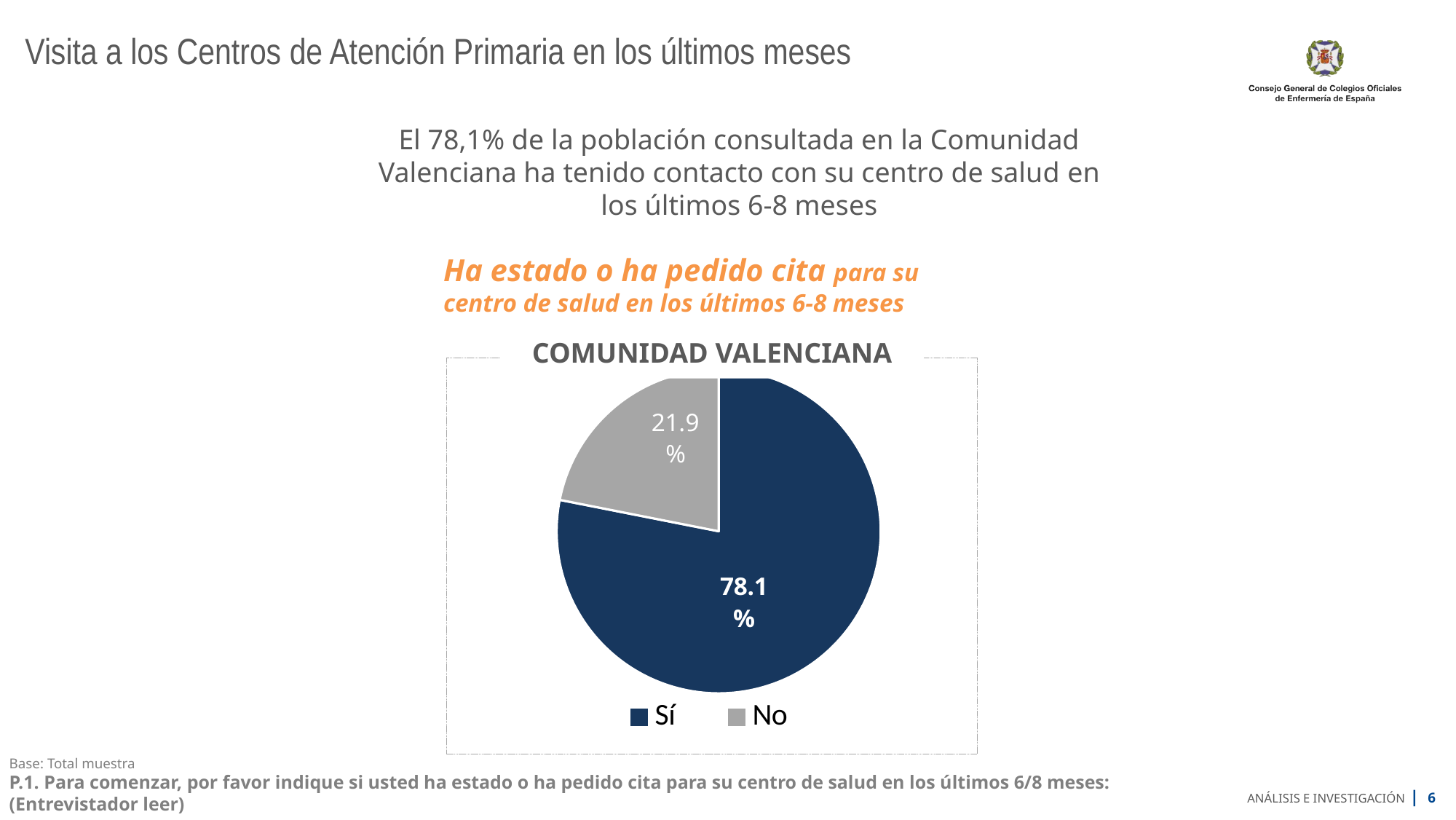
Which category has the largest slice in the pie chart? Sí What is the title of the pie chart? COMUNIDAD VALENCIANA Which category has the smallest slice in the pie chart? No What colour is the Sí slice in the pie chart? Dark blue What share of the pie does the Sí slice represent? 78.1% What is the difference between the Sí and No values in the pie chart? 56.2% What is the value for Sí in the pie chart? 78.1% How many entries does the legend of the pie chart list? 2 What kind of chart is shown under the title COMUNIDAD VALENCIANA? Pie chart Which is larger in the pie chart, Sí or No? Sí How many slices does the pie chart have? 2 What is the value for No in the pie chart? 21.9%